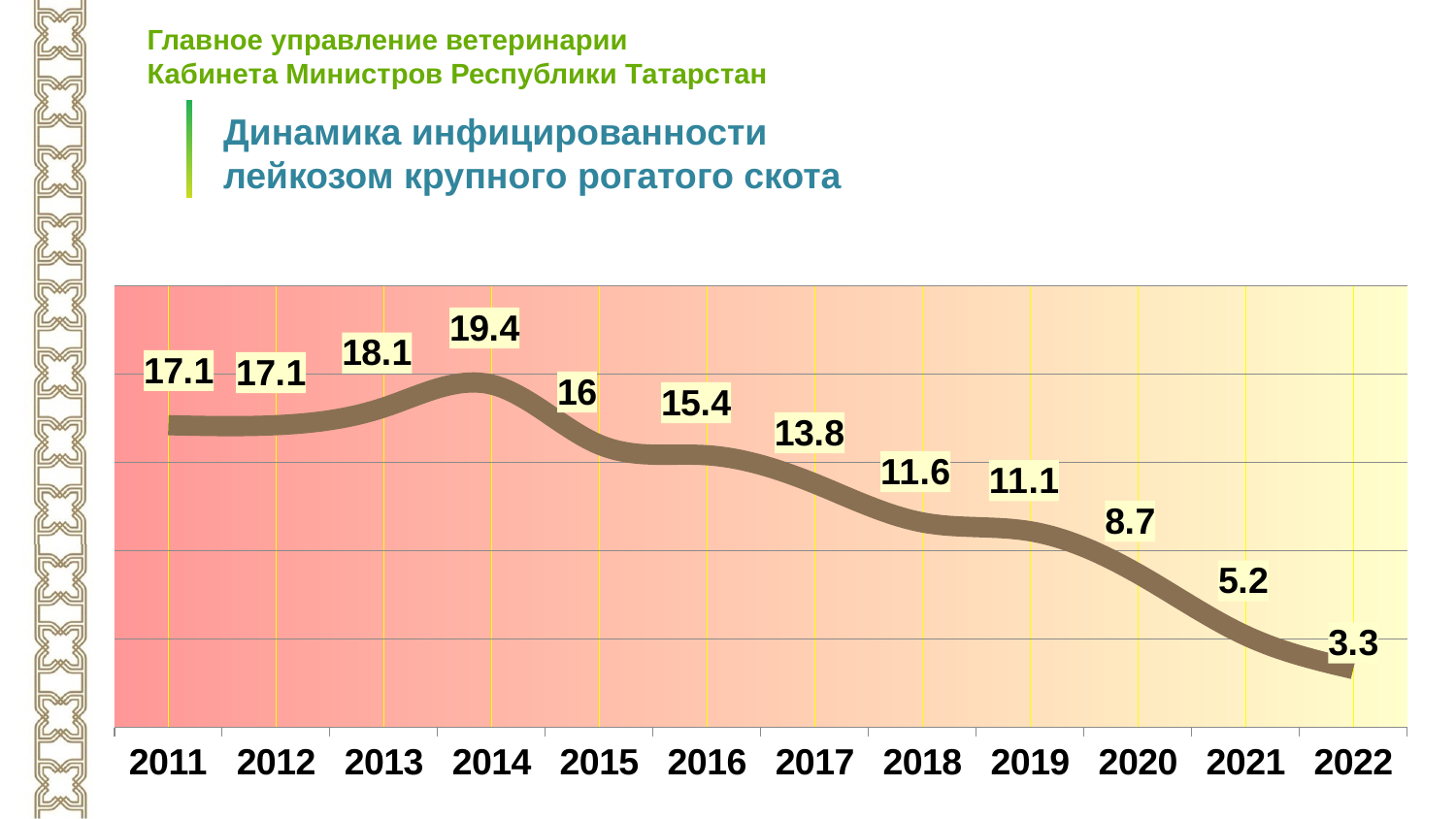
What is the value for 2018? 11.6 What kind of chart is shown on the slide? line chart Which is larger, the value for 2016 or the value for 2019? 2016 Which year has the lowest value? 2022 What is the difference between the values for 2014 and 2022? 16.1 How many years are plotted on the x axis? 12 What is the value for 2014? 19.4 Which year has the highest value? 2014 What is the value for 2022? 3.3 Do the values generally rise or fall from 2014 to 2022? fall What is the value for 2015? 16 What is the difference between the values for 2020 and 2021? 3.5